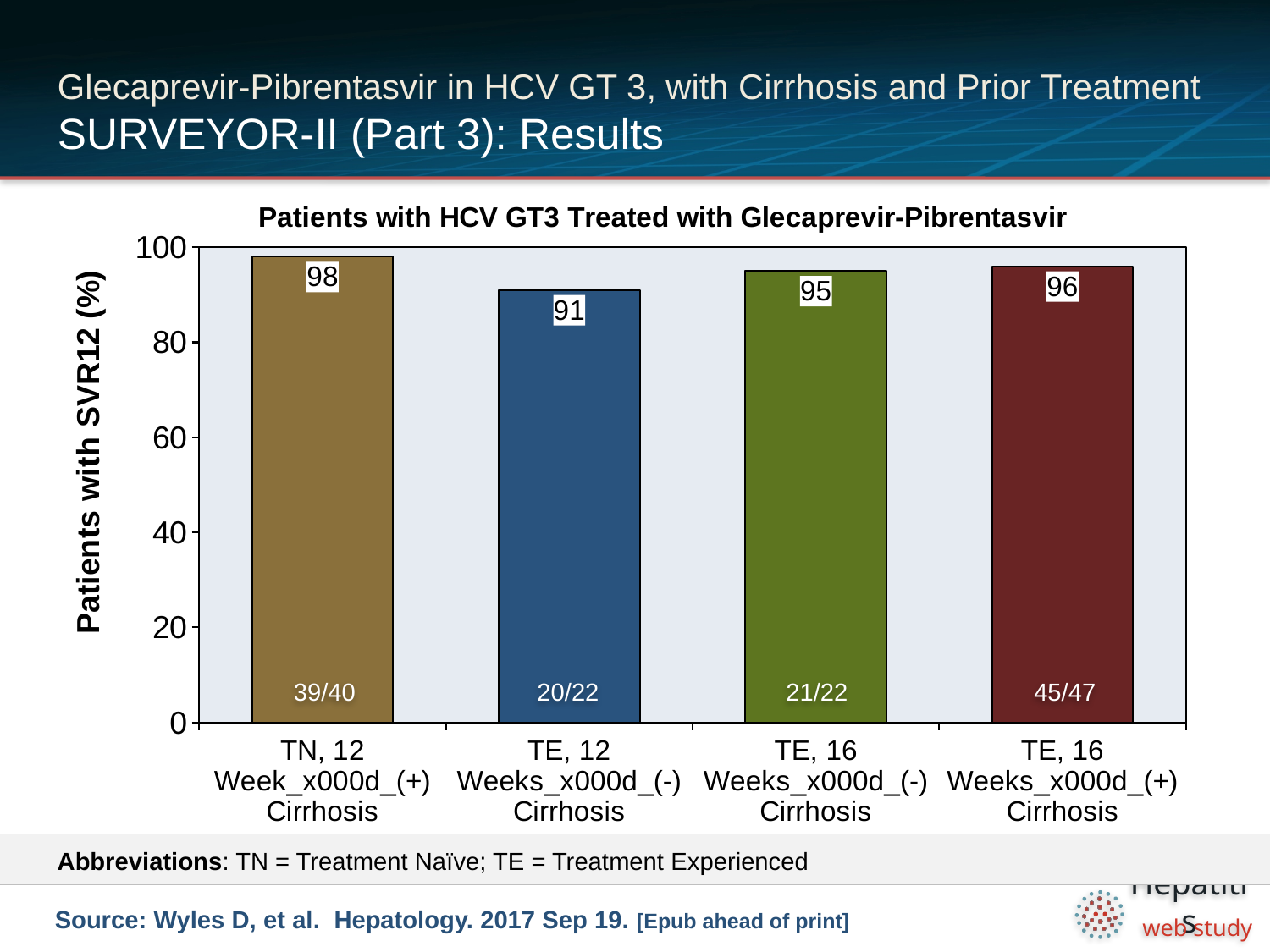
How many groups are shown in the chart? 4 Is the SVR12 rate for the TE, 12 Weeks (-) Cirrhosis group greater or less than 80? greater What is the title of the chart? Patients with HCV GT3 Treated with Glecaprevir-Pibrentasvir What fraction of patients is shown inside the bar for the TE, 16 Weeks (-) Cirrhosis group? 21/22 What is the SVR12 rate for the TE, 12 Weeks (-) Cirrhosis group? 91 What type of chart is shown on the slide? Bar chart Which has a higher SVR12 rate: the TE, 16 Weeks (-) Cirrhosis group or the TE, 12 Weeks (-) Cirrhosis group? TE, 16 Weeks (-) Cirrhosis What is the difference in SVR12 rate between the TN, 12 Week (+) Cirrhosis group and the TE, 12 Weeks (-) Cirrhosis group? 7 Which group has the lowest SVR12 rate? TE, 12 Weeks (-) Cirrhosis Which group has the highest SVR12 rate? TN, 12 Week (+) Cirrhosis What is the SVR12 rate for the TN, 12 Week (+) Cirrhosis group? 98 What is the SVR12 rate for the TE, 16 Weeks (+) Cirrhosis group? 96